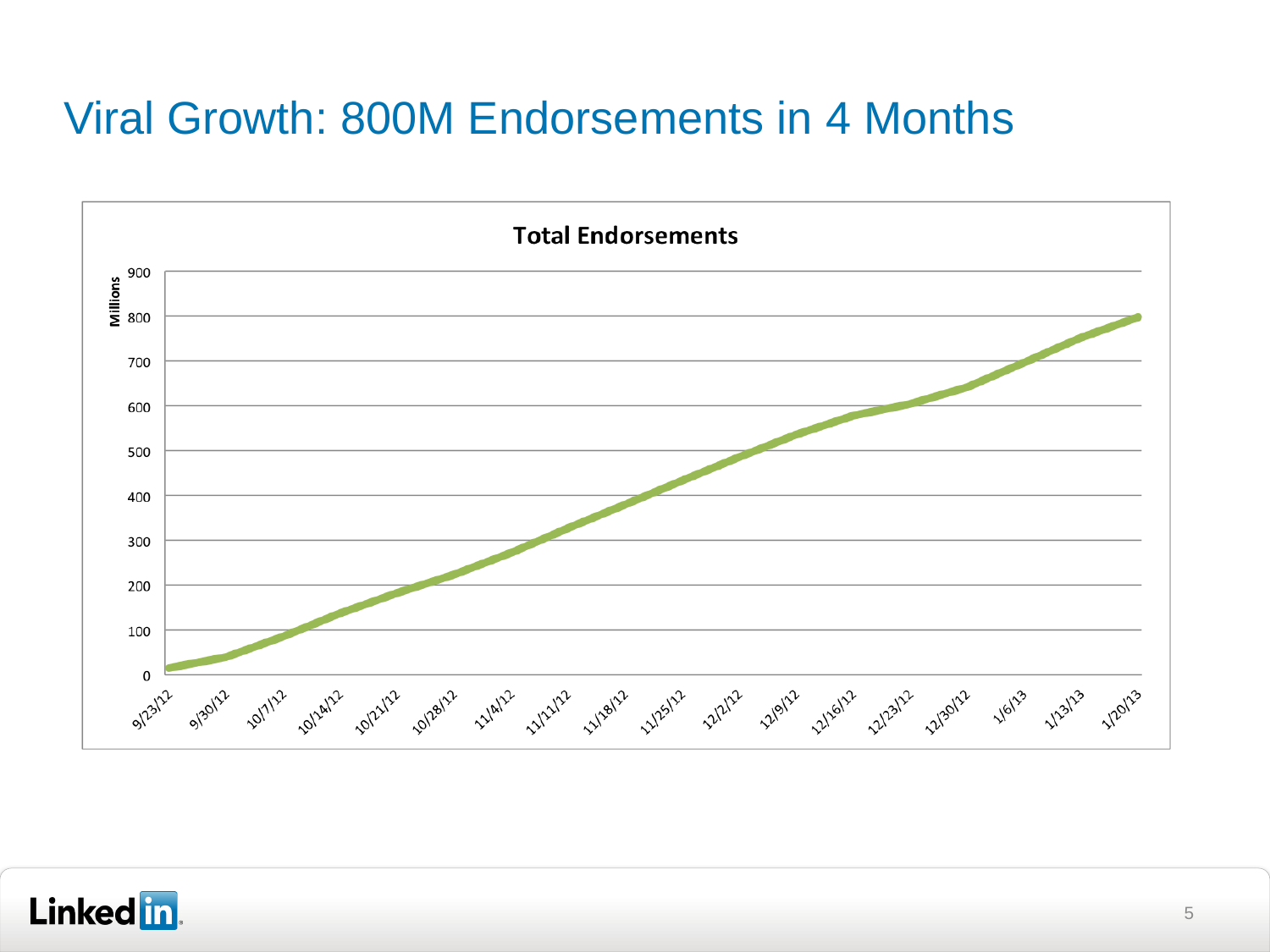
Which date has the lowest value on the chart? 9/23/12 Which date has the highest value on the chart? 1/20/13 What is the title of the chart? Total Endorsements What unit is shown on the y-axis label of the chart? Millions Is the value for 1/13/13 greater or less than 700? greater What kind of chart is shown on the slide? line chart Is the value for 9/23/12 greater or less than 100? less How many date labels are shown on the x axis? 18 Is the value for 10/14/12 greater or less than 100? greater Do the values rise or fall along the x axis from 9/23/12 to 1/20/13? rise Which is larger, the value for 12/9/12 or the value for 10/21/12? 12/9/12